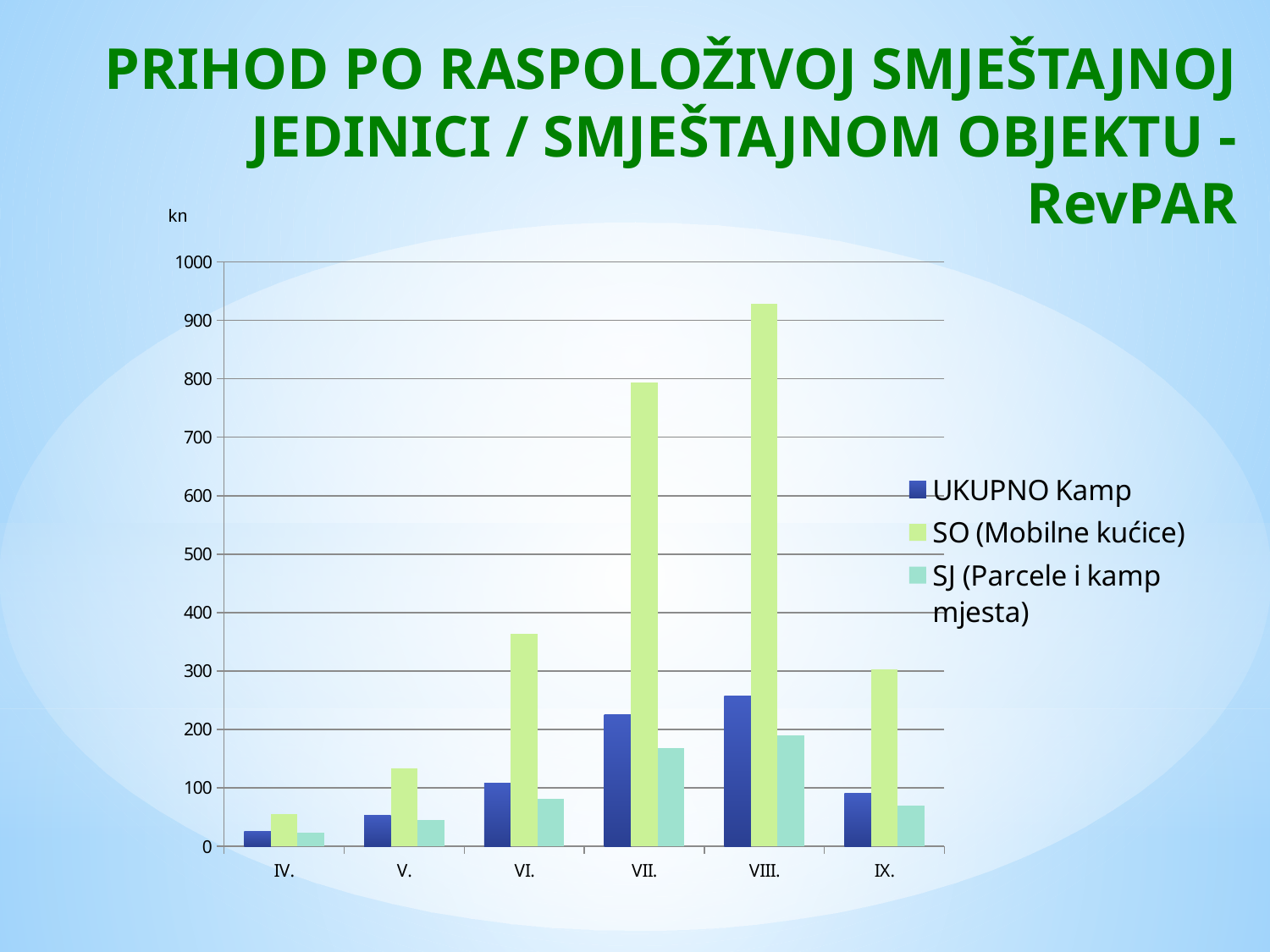
How many series does the legend list? 3 What kind of chart is shown on the slide? bar chart Is the value for UKUPNO Kamp in VIII. greater or less than 200? greater What unit is shown on the y axis? kn In VI., which is larger: SO (Mobilne kućice) or SJ (Parcele i kamp mjesta)? SO (Mobilne kućice) How many categories (months) are shown on the x axis? 6 Is the value for SO (Mobilne kućice) in VIII. greater or less than 900? greater Do the values for SO (Mobilne kućice) rise or fall from IV. to VIII.? rise Is the value for SO (Mobilne kućice) in VII. greater or less than 700? greater In which month is the value for SO (Mobilne kućice) lowest? IV. In which month is the value for SO (Mobilne kućice) highest? VIII.